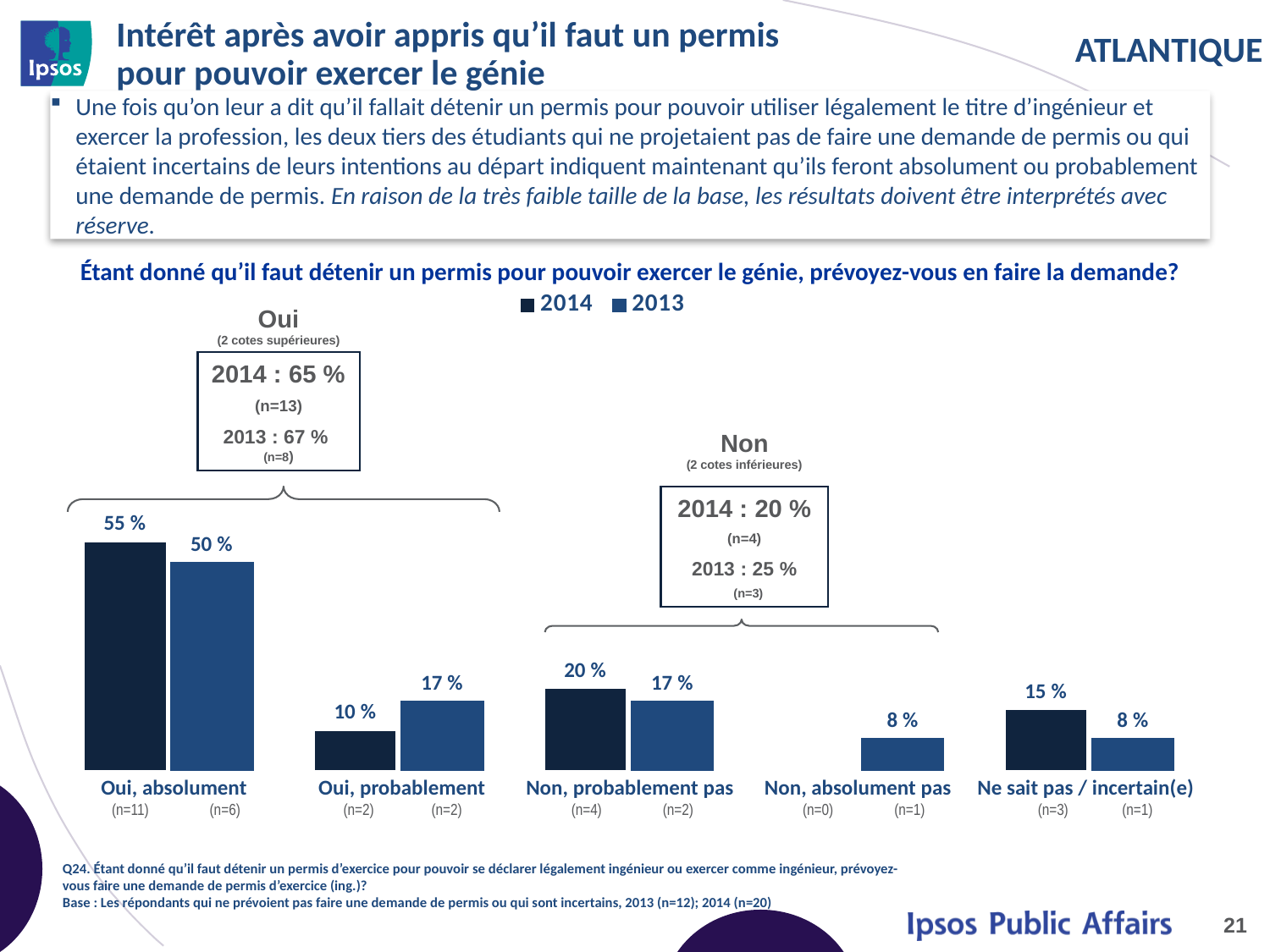
For "Oui, probablement", which year has the larger value, 2014 or 2013? 2013 What is the 2014 value for "Ne sait pas / incertain(e)"? 15 % What is the difference between the 2014 and 2013 values for "Oui, absolument"? 5 % What is the 2013 value for "Oui, probablement"? 17 % How many series does the legend list? 2 How many categories are shown on the x axis of the chart? 5 Which category has the highest 2014 value? Oui, absolument Which category has the lowest 2013 value? Non, absolument pas (tied with Ne sait pas / incertain(e) at 8 %) What kind of chart is shown on the slide? Bar chart What is the 2014 total for "Oui (2 cotes supérieures)" shown in the box above the chart? 65 % What is the 2013 value for "Non, absolument pas"? 8 % What is the 2014 value for "Oui, absolument"? 55 %